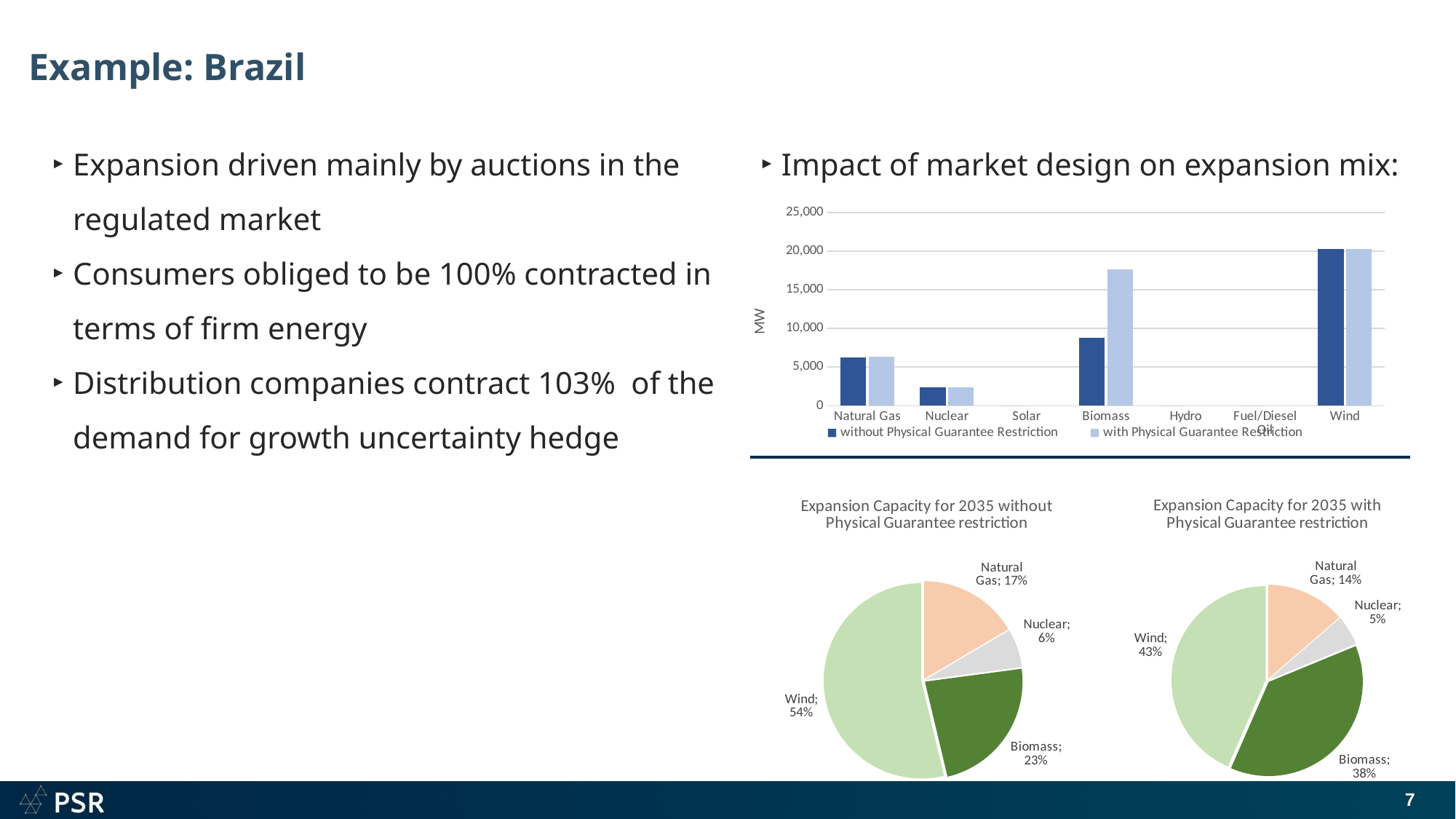
In the top-right bar chart, how many series does the legend list? 2 In the pie chart 'Expansion Capacity for 2035 with Physical Guarantee restriction', which slice is the smallest? Nuclear In the top-right bar chart, is the value for Nuclear without Physical Guarantee Restriction greater or less than 5,000? less In the top-right bar chart, how many categories are shown on the x axis? 7 In the top-right bar chart, which category has the highest values? Wind In the top-right bar chart, is the value for Biomass with Physical Guarantee Restriction greater or less than 15,000? greater In the top-right bar chart, which is larger for Biomass: the value without Physical Guarantee Restriction or with Physical Guarantee Restriction? with Physical Guarantee Restriction In the pie chart 'Expansion Capacity for 2035 without Physical Guarantee restriction', what share does Wind have? 54% What kind of chart is the top-right chart under 'Impact of market design on expansion mix'? bar chart What is the difference between the Biomass share in the 'with Physical Guarantee restriction' pie chart and the Biomass share in the 'without Physical Guarantee restriction' pie chart? 15% In the top-right bar chart, is the value for Biomass without Physical Guarantee Restriction greater or less than 10,000? less In the pie chart 'Expansion Capacity for 2035 with Physical Guarantee restriction', what share does Biomass have? 38%